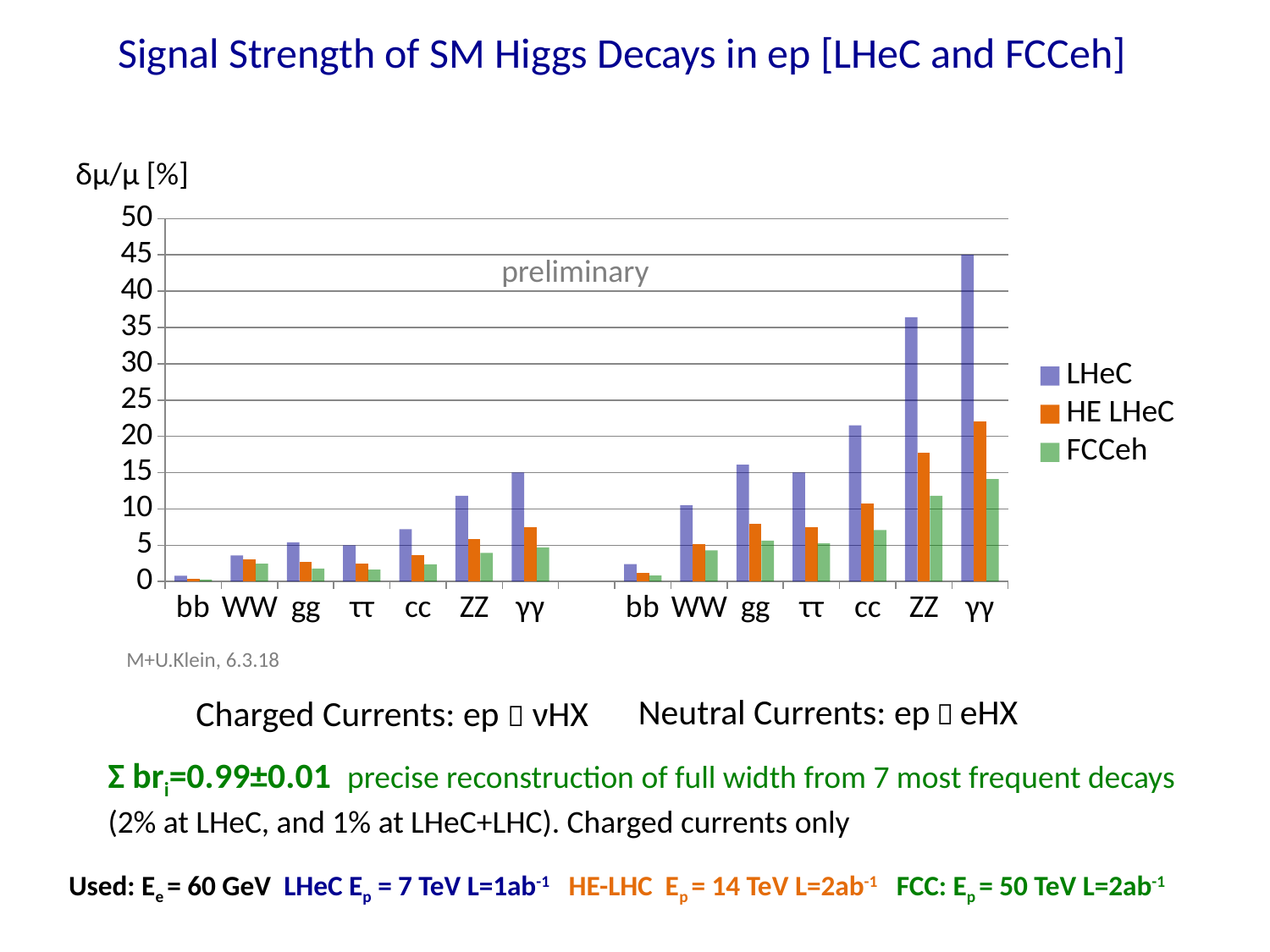
Which decay channel has the highest LHeC bar on the chart? γγ (Neutral Currents) What are the three series named in the legend? LHeC, HE LHeC, FCCeh How many series does the legend list? 3 Is the LHeC value for cc in the Neutral Currents group greater or less than 25? less Is the LHeC value for ZZ in the Neutral Currents group greater or less than 30? greater For ZZ in the Neutral Currents group, which is larger: the HE LHeC value or the FCCeh value? HE LHeC What is the label on the vertical axis of the chart? δμ/μ [%] Is the LHeC value for γγ in the Neutral Currents group greater or less than 40? greater Which decay channel has the lowest LHeC bar on the chart? bb (Charged Currents) What kind of chart is shown on the slide? bar chart How many decay channels are shown in the Neutral Currents group on the right? 7